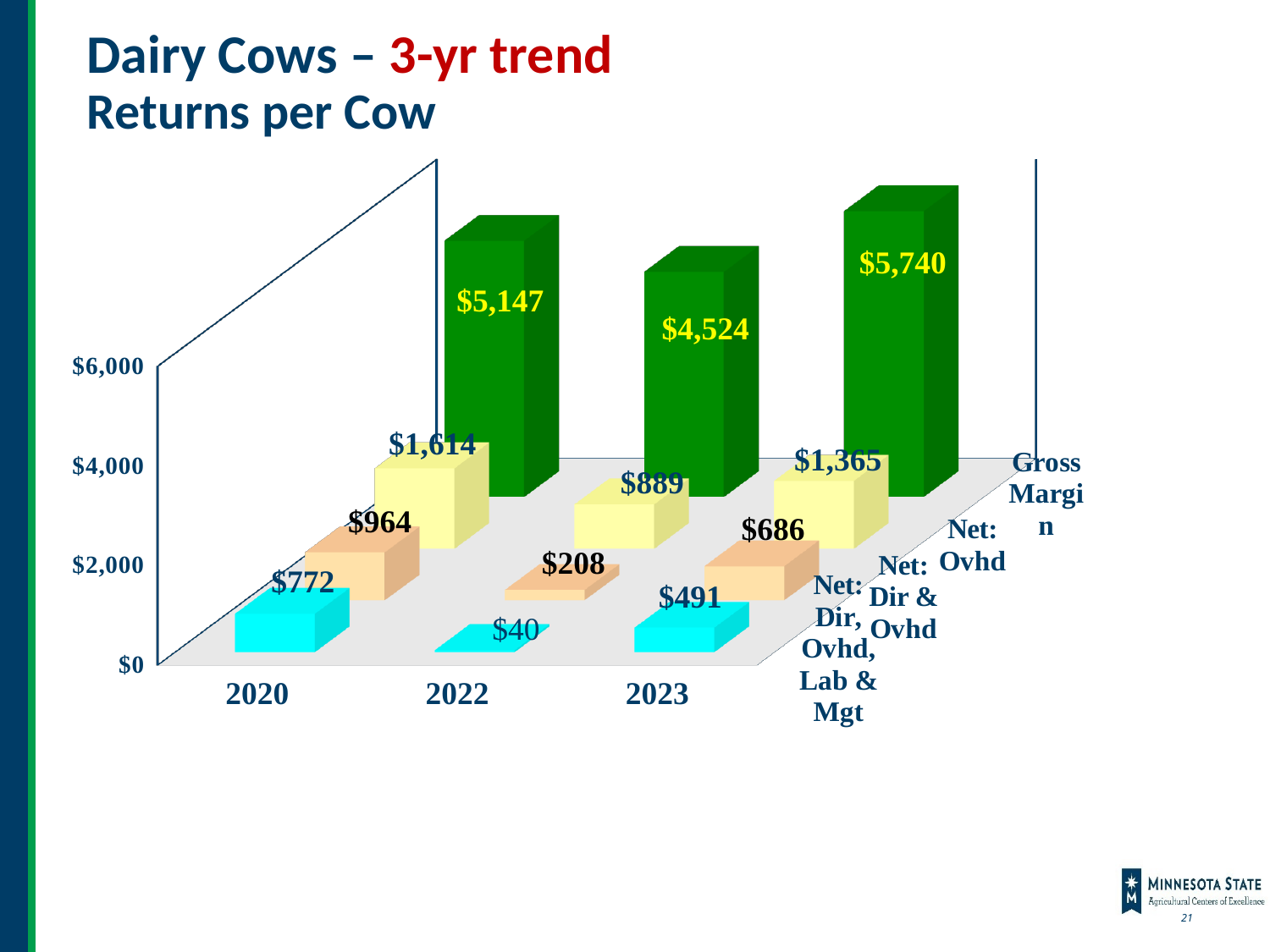
What is the Net: Dir & Ovhd value for 2022? $208 What kind of chart is shown on the slide? bar chart What is the Net: Ovhd value for 2020? $1,614 How many years are shown on the x axis? 3 Which year has the lowest Gross Margin? 2022 Is the Gross Margin for 2020 greater or less than $4,000? greater What is the Gross Margin per cow in 2022? $4,524 Which year has the highest Gross Margin? 2023 What is the Gross Margin per cow in 2023? $5,740 Which year has the larger Net: Ovhd value, 2020 or 2023? 2020 By how much does the Gross Margin in 2023 exceed the Gross Margin in 2022? $1,216 What is the smallest value labelled on the chart? $40